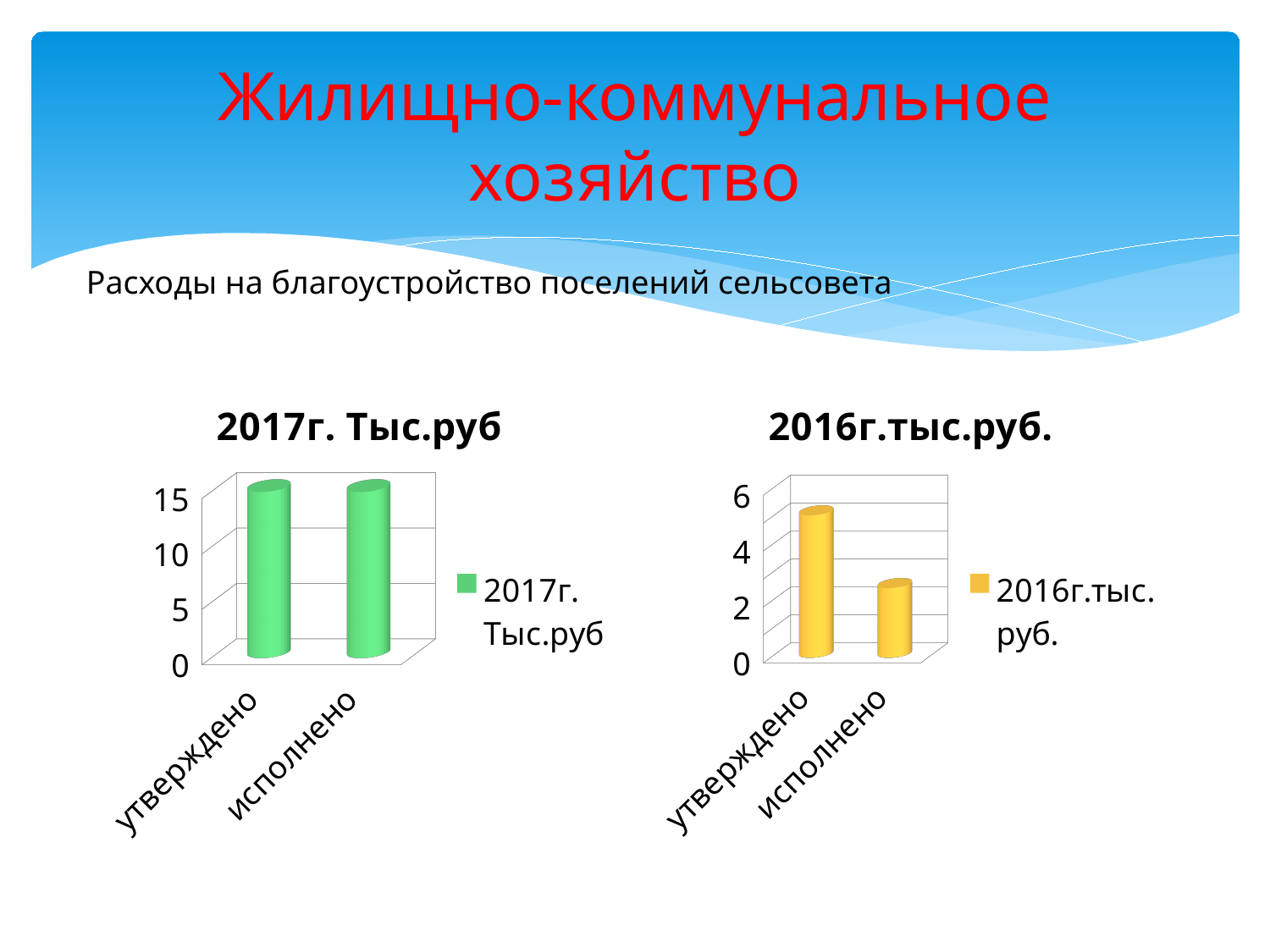
How many series does the legend of the chart titled "2017г. Тыс.руб" list? 1 In the chart titled "2016г.тыс.руб.", which category has the higher value, утверждено or исполнено? утверждено In the chart titled "2016г.тыс.руб.", is the value for утверждено greater or less than 4? greater In the chart titled "2017г. Тыс.руб", is the value for исполнено greater or less than 10? greater What kind of chart is the chart titled "2016г.тыс.руб."? bar chart In the chart titled "2017г. Тыс.руб", is the value for утверждено greater or less than 10? greater In the chart titled "2016г.тыс.руб.", how many categories are shown on the x axis? 2 What colour are the bars in the chart titled "2016г.тыс.руб."? yellow What kind of chart is the chart titled "2017г. Тыс.руб"? bar chart In the chart titled "2017г. Тыс.руб", how many categories are shown on the x axis? 2 In the chart titled "2016г.тыс.руб.", which category has the lowest value? исполнено